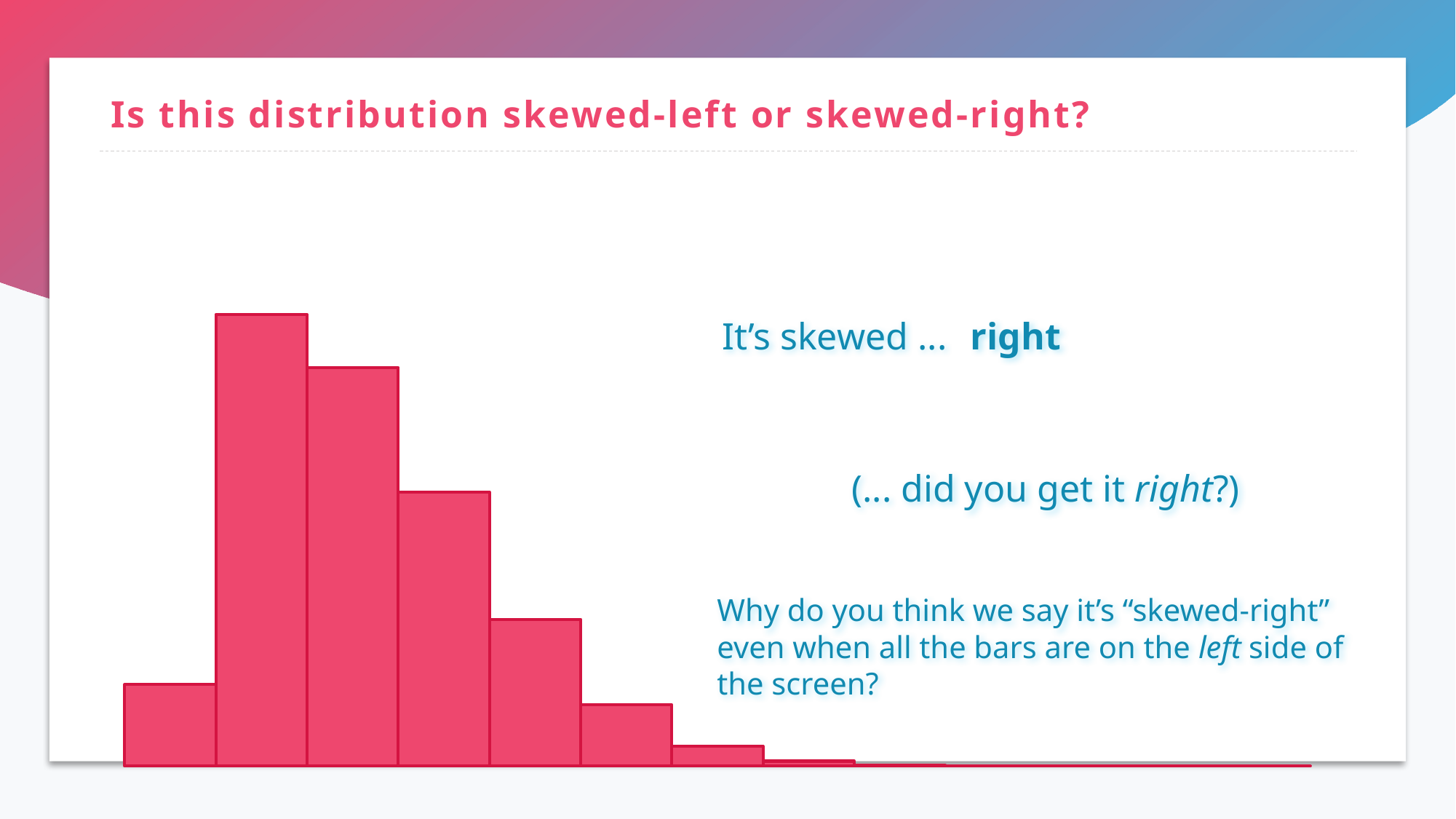
What kind of chart is shown on the slide? bar chart Is the fourth bar from the left taller or shorter than the fifth bar from the left? taller Which bar is the tallest in the chart? the second bar from the left Is the first bar from the left taller or shorter than the second bar from the left? shorter From the second bar onward, do the bar heights rise or fall moving to the right? fall Is the second bar from the left taller or shorter than the third bar from the left? taller According to the slide, is the distribution skewed-left or skewed-right? skewed-right What colour are the bars in the chart? red/pink